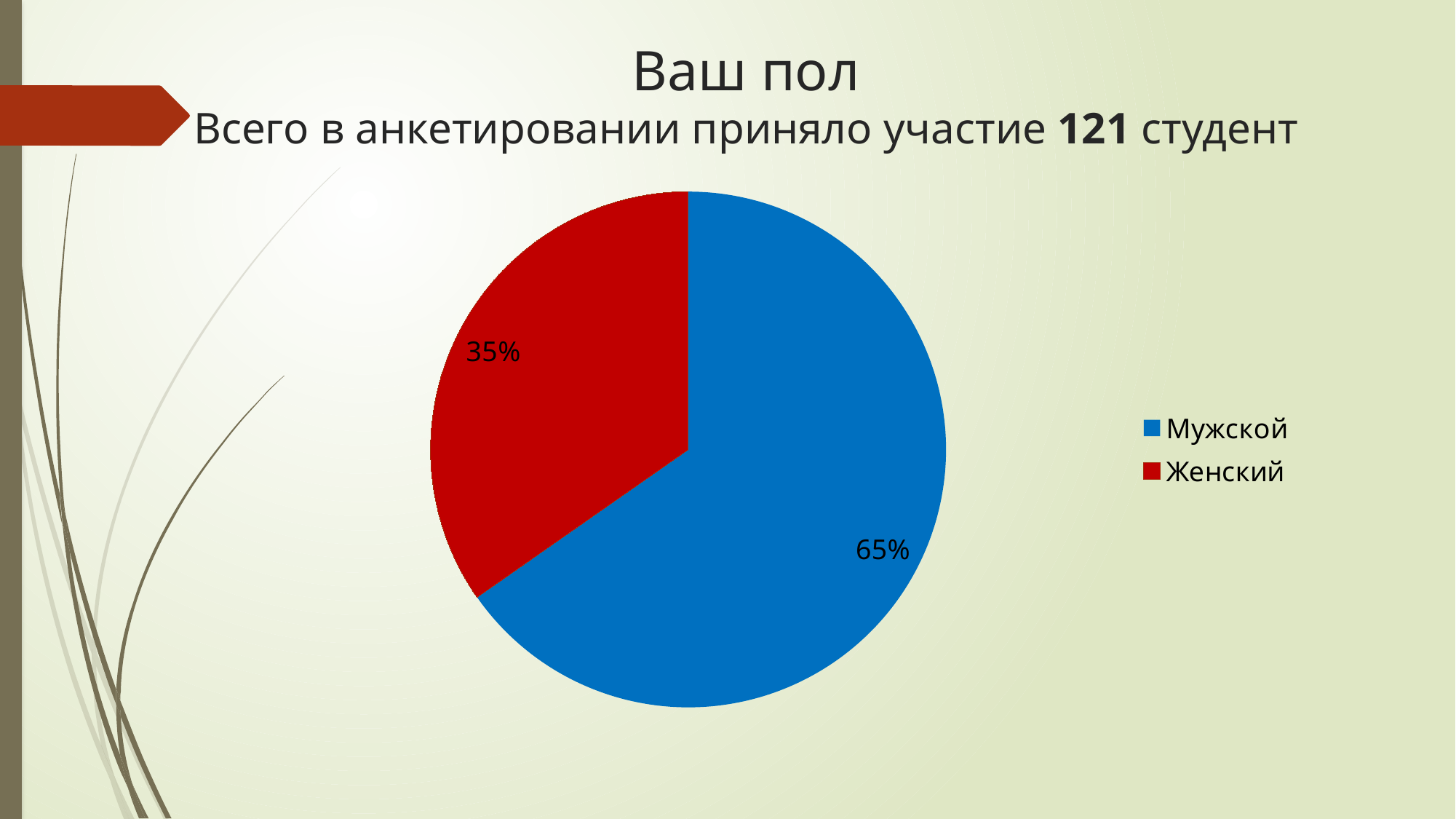
Which slice is larger, Мужской or Женский? Мужской How many entries does the legend list? 2 What is the difference in percentage points between the Мужской and Женский slices? 30% What share of the pie does Мужской take? 65% What share of the pie does Женский take? 35% Which category has the largest slice of the pie? Мужской What is the title of the slide above the chart? Ваш пол Which category has the smallest slice of the pie? Женский What colour is the Женский slice? Red How many slices does the pie chart have? 2 What kind of chart is shown on the slide? Pie chart